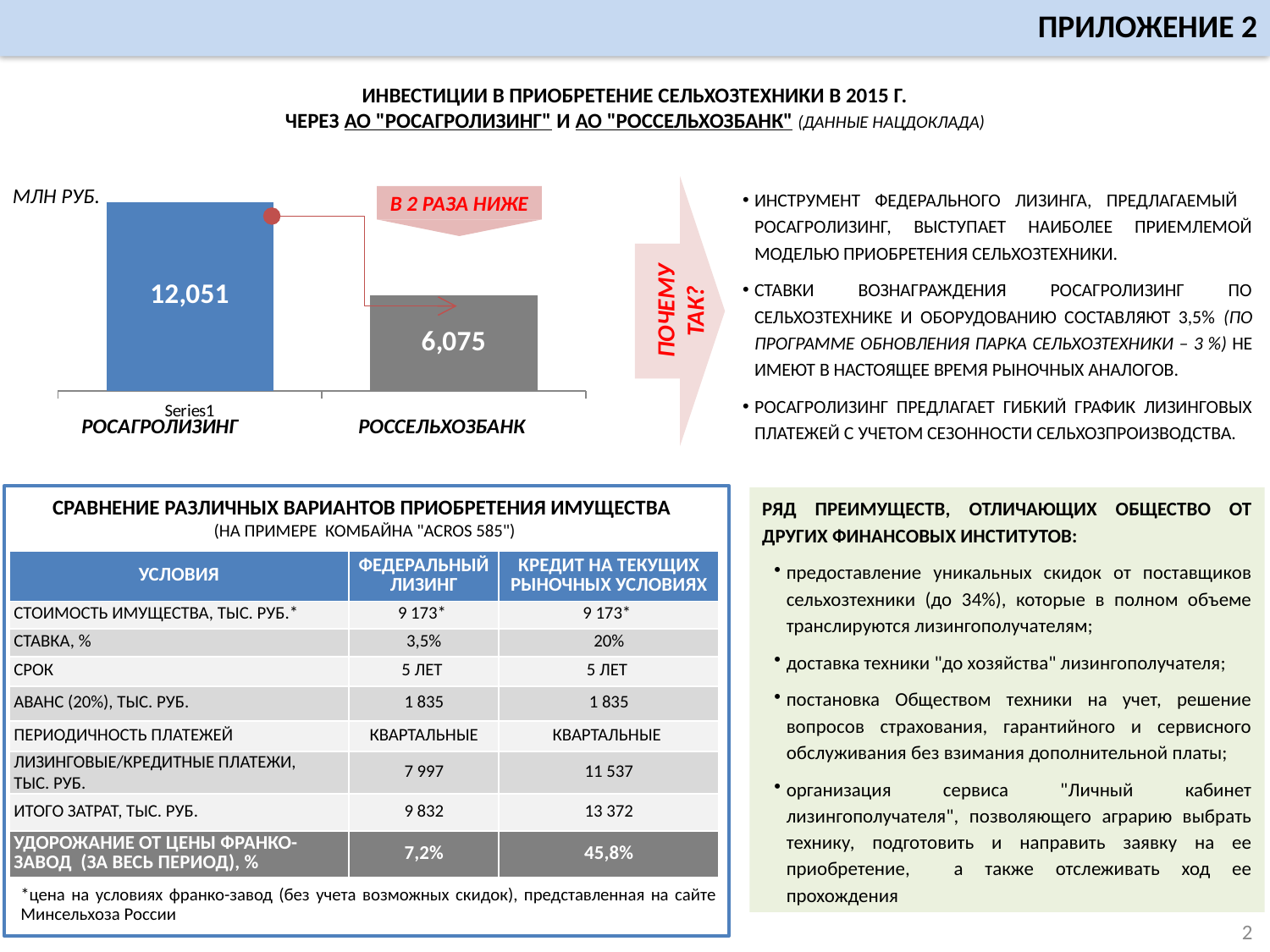
What is the value for РОСАГРОЛИЗИНГ in the bar chart? 12,051 What is the difference between the values for РОСАГРОЛИЗИНГ and РОССЕЛЬХОЗБАНК in the bar chart? 5,976 How many categories (bars) are shown in the bar chart? 2 Which is larger in the bar chart, the value for РОСАГРОЛИЗИНГ or for РОССЕЛЬХОЗБАНК? РОСАГРОЛИЗИНГ Do the values in the bar chart rise or fall from left to right? Fall Which category has the highest value in the bar chart? РОСАГРОЛИЗИНГ Which category has the lowest value in the bar chart? РОССЕЛЬХОЗБАНК What is the value for РОССЕЛЬХОЗБАНК in the bar chart? 6,075 What unit is indicated for the values in the bar chart? МЛН РУБ. What does the annotation above the РОССЕЛЬХОЗБАНК bar say? В 2 РАЗА НИЖЕ What kind of chart is shown on the slide? Bar chart